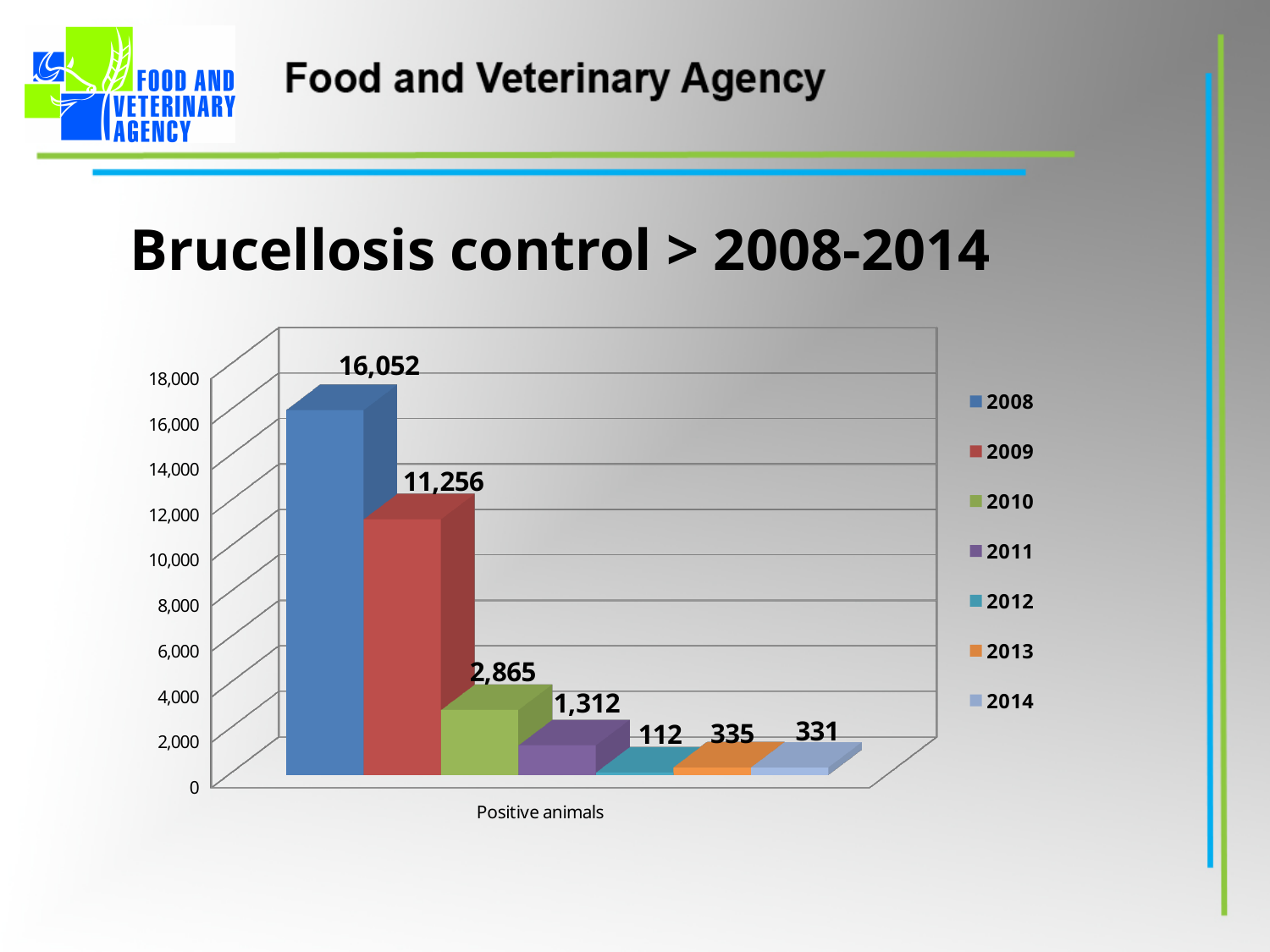
What kind of chart is shown on the slide? bar chart Which year has the lowest number of positive animals? 2012 What is the difference between the values for 2013 and 2014? 4 What is the value for 2012 in the Positive animals chart? 112 What is the label on the x axis of the chart? Positive animals What is the value for 2008 in the Positive animals chart? 16,052 What is the difference between the values for 2008 and 2009? 4,796 Which is larger, the value for 2010 or the value for 2011? 2010 How many series does the legend list? 7 Which year has the highest number of positive animals? 2008 Is the value for 2009 greater or less than 10,000? greater What is the value for 2010 in the Positive animals chart? 2,865